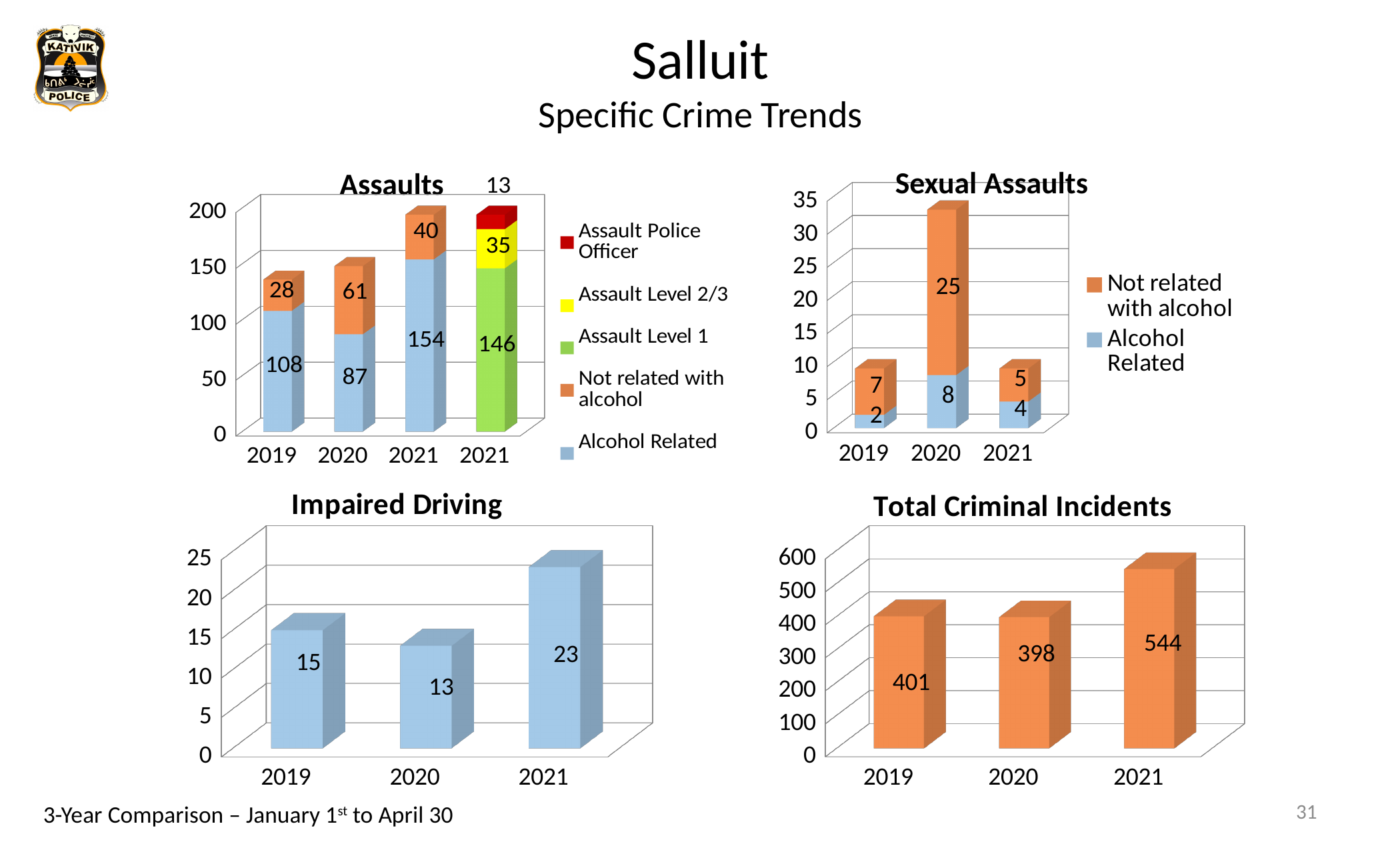
In the Assaults chart, what is the Assault Level 2/3 value for 2021? 35 How many series does the legend of the Assaults chart list? 5 In the Assaults chart, what is the Not related with alcohol value for 2020? 61 In the Sexual Assaults chart, what is the Not related with alcohol value for 2020? 25 In the Impaired Driving chart, which year has the lowest value? 2020 In the Assaults chart, what is the Alcohol Related value for 2019? 108 In the Impaired Driving chart, which year has the highest value? 2021 In the Sexual Assaults chart, what is the total of the stacked bar for 2020? 33 In the Total Criminal Incidents chart, what is the value for 2021? 544 What kind of chart is the Impaired Driving chart? Bar chart In the Total Criminal Incidents chart, which is larger, the value for 2019 or the value for 2020? 2019 In the Total Criminal Incidents chart, what is the difference between the 2021 and 2019 values? 143